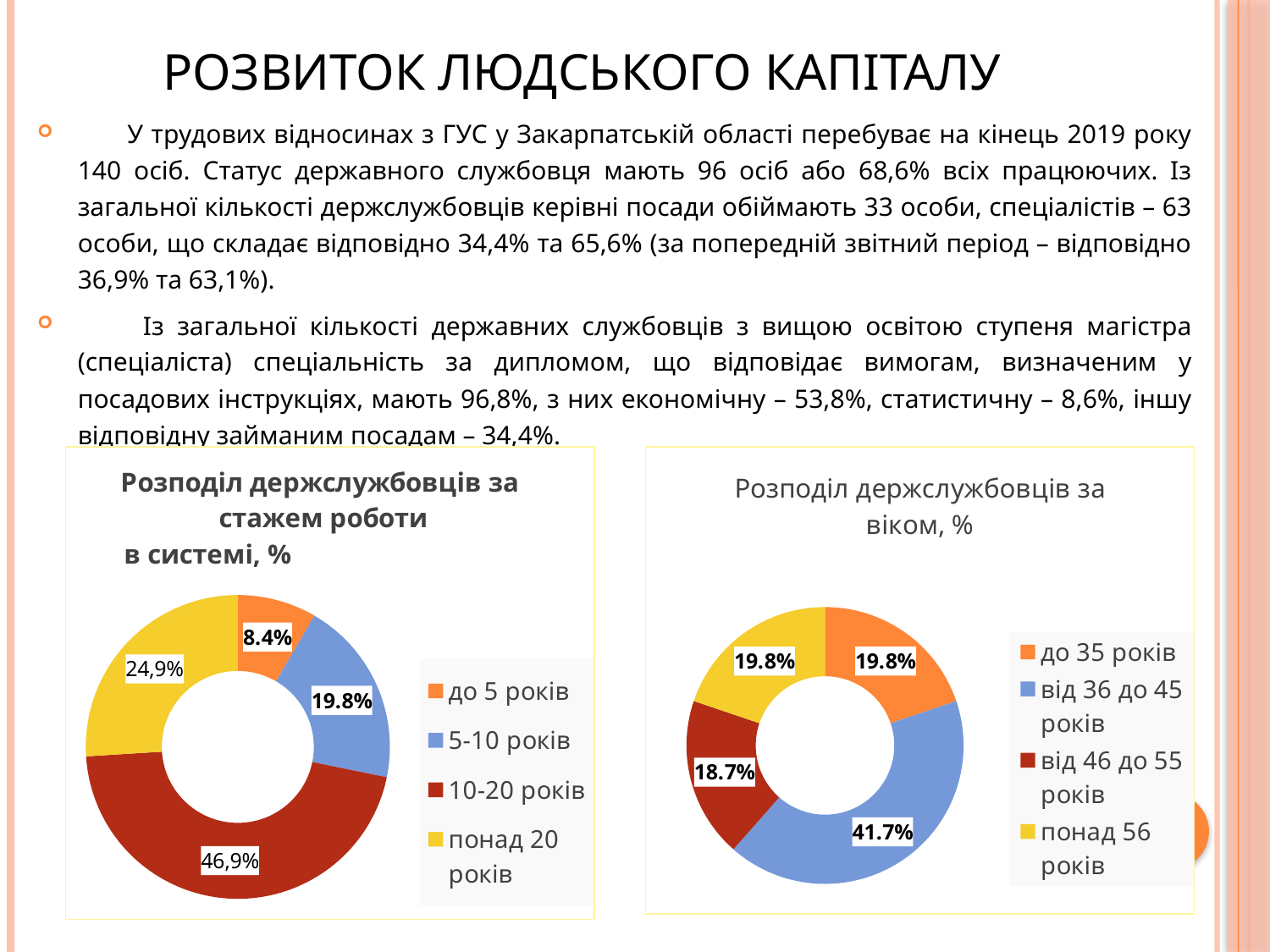
What type of chart is the left chart (Розподіл держслужбовців за стажем роботи в системі, %)? Doughnut chart In the right chart (Розподіл держслужбовців за віком, %), what is the difference between 'від 36 до 45 років' and 'від 46 до 55 років'? 23.0% In the left chart (Розподіл держслужбовців за стажем роботи в системі, %), what is the value for '10-20 років'? 46,9% In the right chart (Розподіл держслужбовців за віком, %), which colour represents 'понад 56 років'? Yellow In the left chart (Розподіл держслужбовців за стажем роботи в системі, %), which category has the largest share? 10-20 років In the right chart (Розподіл держслужбовців за віком, %), what is the value for 'від 36 до 45 років'? 41.7% In the left chart (Розподіл держслужбовців за стажем роботи в системі, %), how many categories does the legend list? 4 In the left chart (Розподіл держслужбовців за стажем роботи в системі, %), which category has the smallest share? до 5 років In the right chart (Розподіл держслужбовців за віком, %), what is the value for 'від 46 до 55 років'? 18.7% In the right chart (Розподіл держслужбовців за віком, %), which category has the largest share? від 36 до 45 років In the right chart (Розподіл держслужбовців за віком, %), which is larger: 'до 35 років' or 'від 46 до 55 років'? до 35 років In the left chart (Розподіл держслужбовців за стажем роботи в системі, %), what is the value for 'до 5 років'? 8.4%